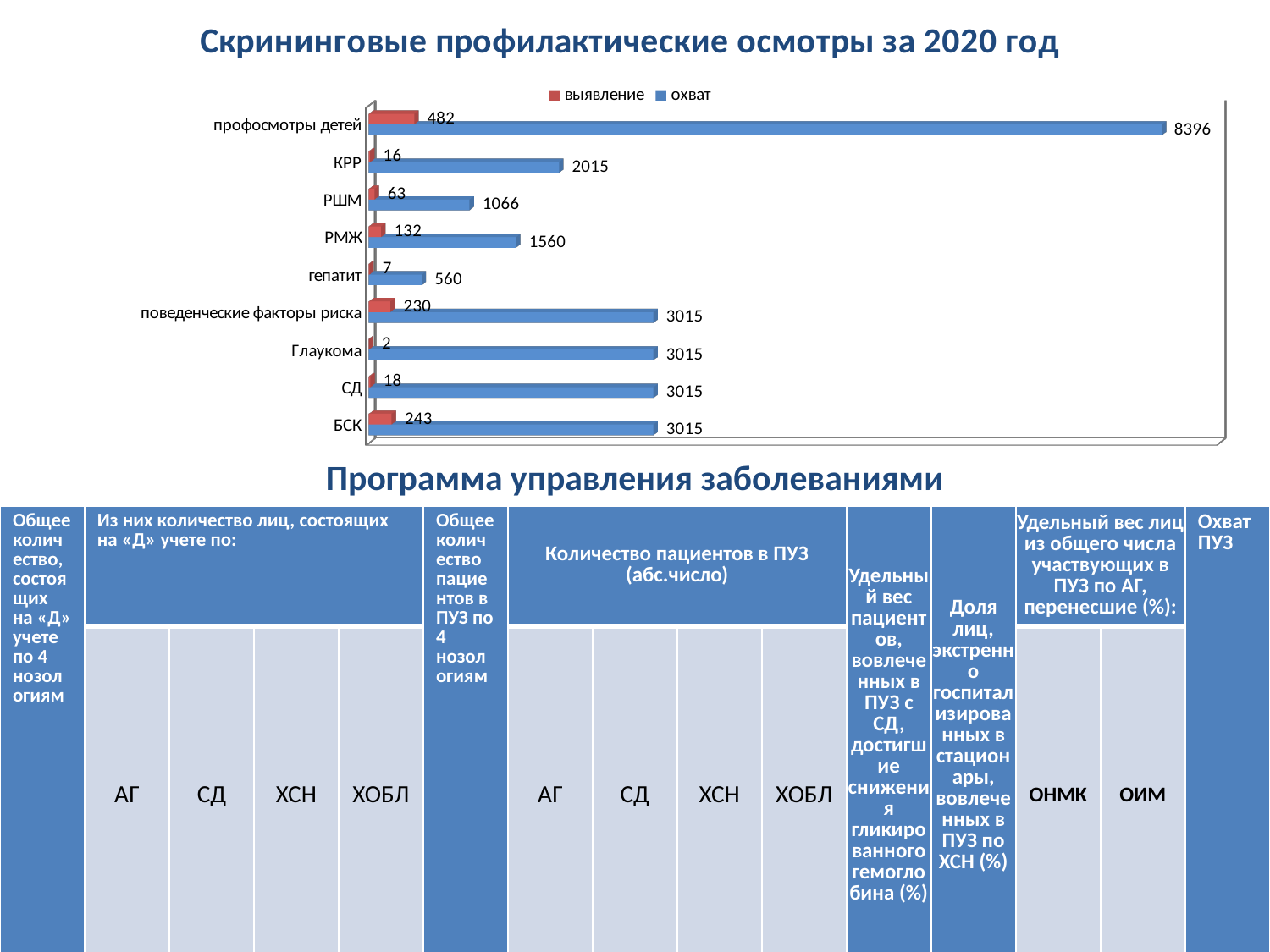
What is the "выявление" value for РМЖ? 132 Which category has the lowest "выявление" value? Глаукома What is the "охват" value for профосмотры детей? 8396 Which category has the highest "охват" value? профосмотры детей What is the title of the chart? Скрининговые профилактические осмотры за 2020 год What is the difference between the "охват" and "выявление" values for СД? 2997 What is the "охват" value for гепатит? 560 How many series does the legend list? 2 Which is larger, the "выявление" value for БСК or for поведенческие факторы риска? БСК How many categories are shown on the chart? 9 What is the difference between the "охват" values for КРР and РШМ? 949 What kind of chart is shown on the slide? bar chart